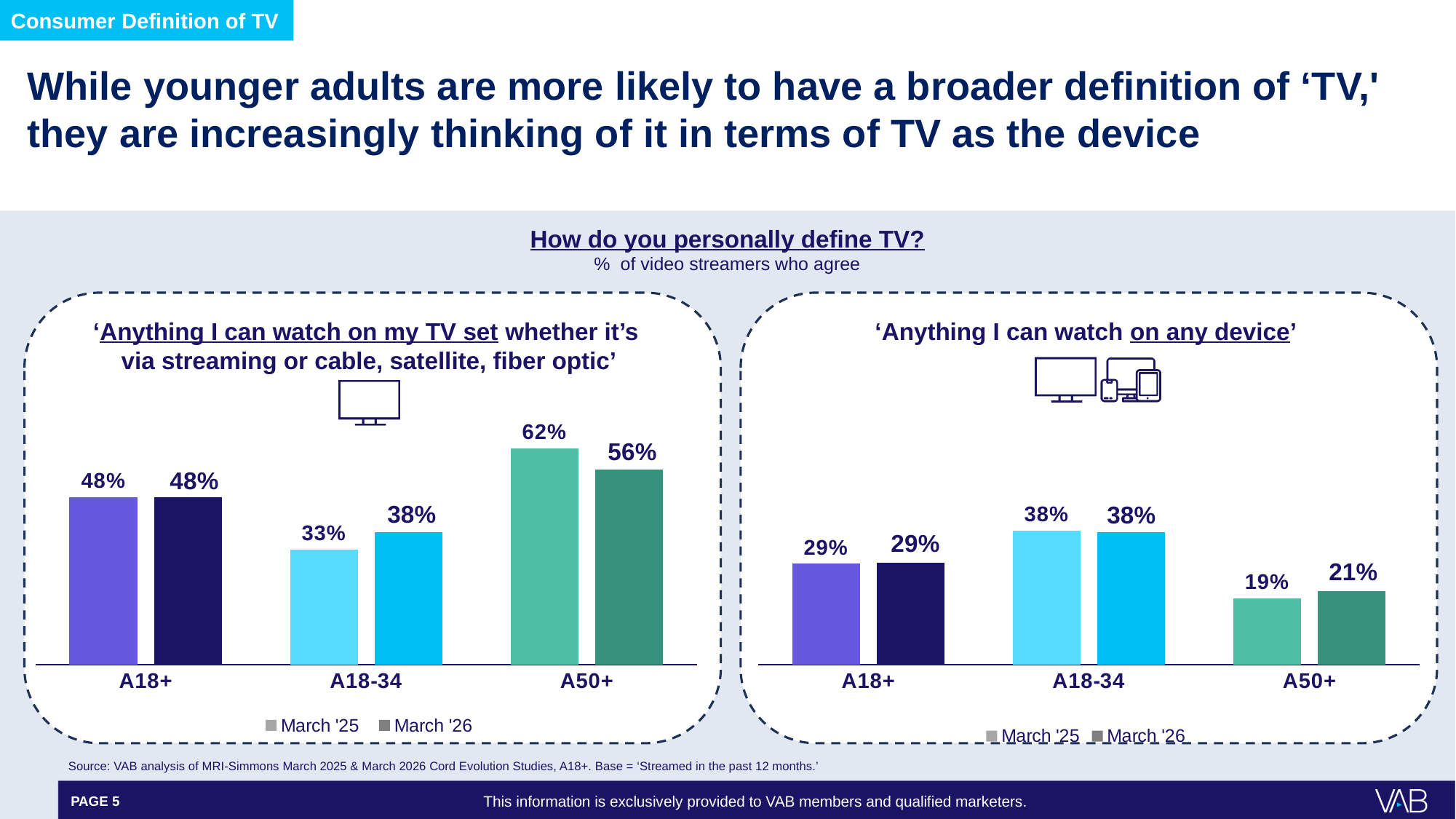
In the 'Anything I can watch on my TV set' chart, which is larger for A18-34: the March '25 value or the March '26 value? March '26 How many age groups are shown in the 'Anything I can watch on any device' chart? 3 In the 'Anything I can watch on my TV set' chart, which age group has the highest value in March '26? A50+ In the 'Anything I can watch on any device' chart, what is the difference between the March '26 values for A18-34 and A50+? 17% In the 'Anything I can watch on my TV set' chart, what is the difference between the March '25 and March '26 values for A50+? 6% In the 'Anything I can watch on any device' chart, what is the value for A18-34 in March '26? 38% What type of chart is the 'Anything I can watch on any device' chart? Bar chart In the 'Anything I can watch on any device' chart, what is the value for A50+ in March '25? 19% In the 'Anything I can watch on any device' chart, which age group has the lowest value in March '25? A50+ In the 'Anything I can watch on my TV set' chart, what is the value for A18-34 in March '25? 33% In the 'Anything I can watch on my TV set' chart, what is the value for A50+ in March '26? 56% How many series does the legend of the 'Anything I can watch on my TV set' chart list? 2